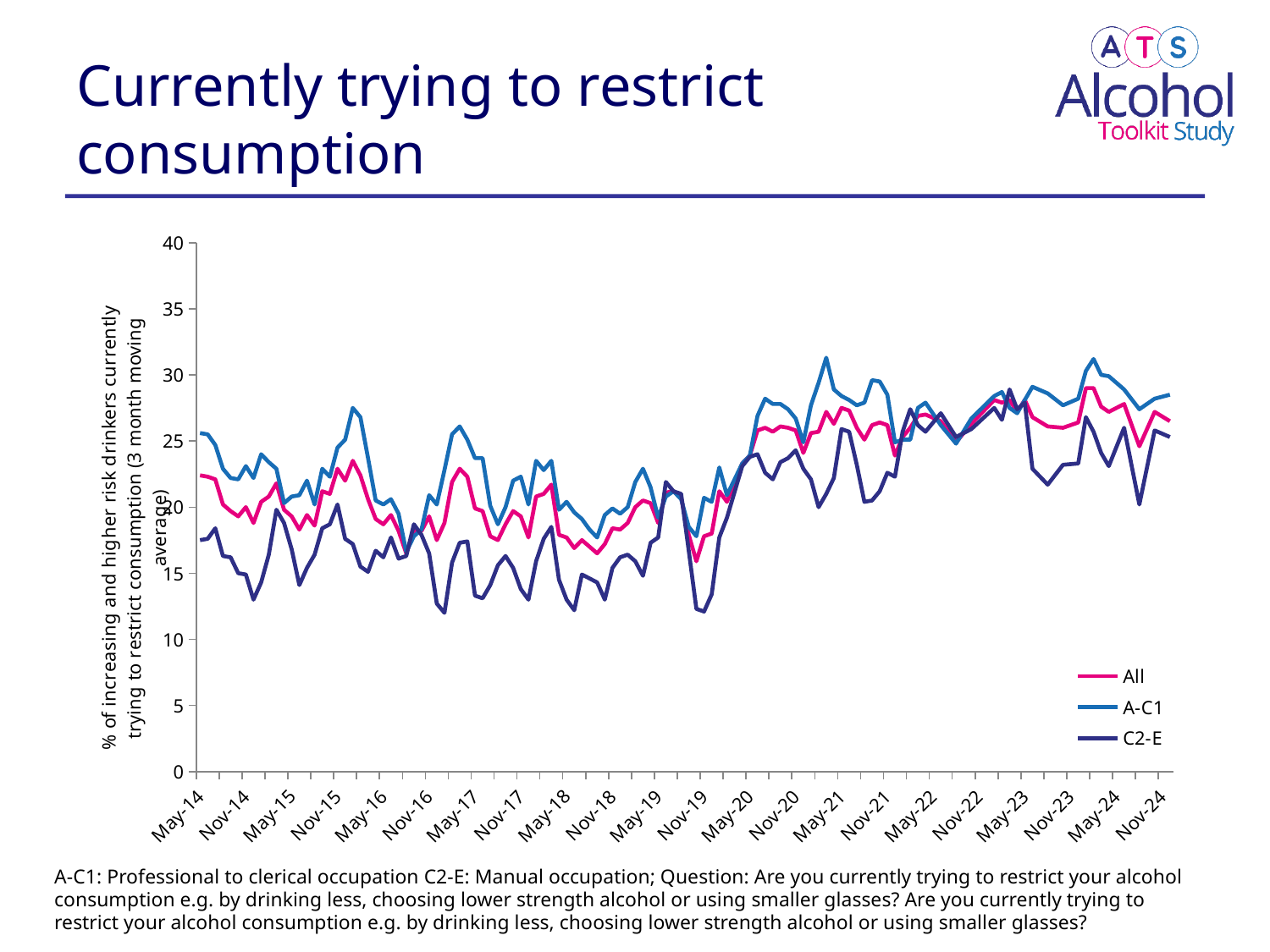
Which series has the lowest value at Nov-16? C2-E Does the C2-E line rise or fall between May-19 and Nov-19? Fall What are the three series named in the legend? All, A-C1, C2-E How many series does the legend list? 3 At May-14, which series has the larger value, A-C1 or C2-E? A-C1 What is the title of the chart on the slide? Currently trying to restrict consumption Is the value for C2-E at Nov-16 greater or less than 15? greater How many date labels are shown along the x axis? 22 Is the value for All at Nov-19 greater or less than 20? less Is the value for A-C1 at May-21 greater or less than 30? less What kind of chart is shown on the slide? Line chart